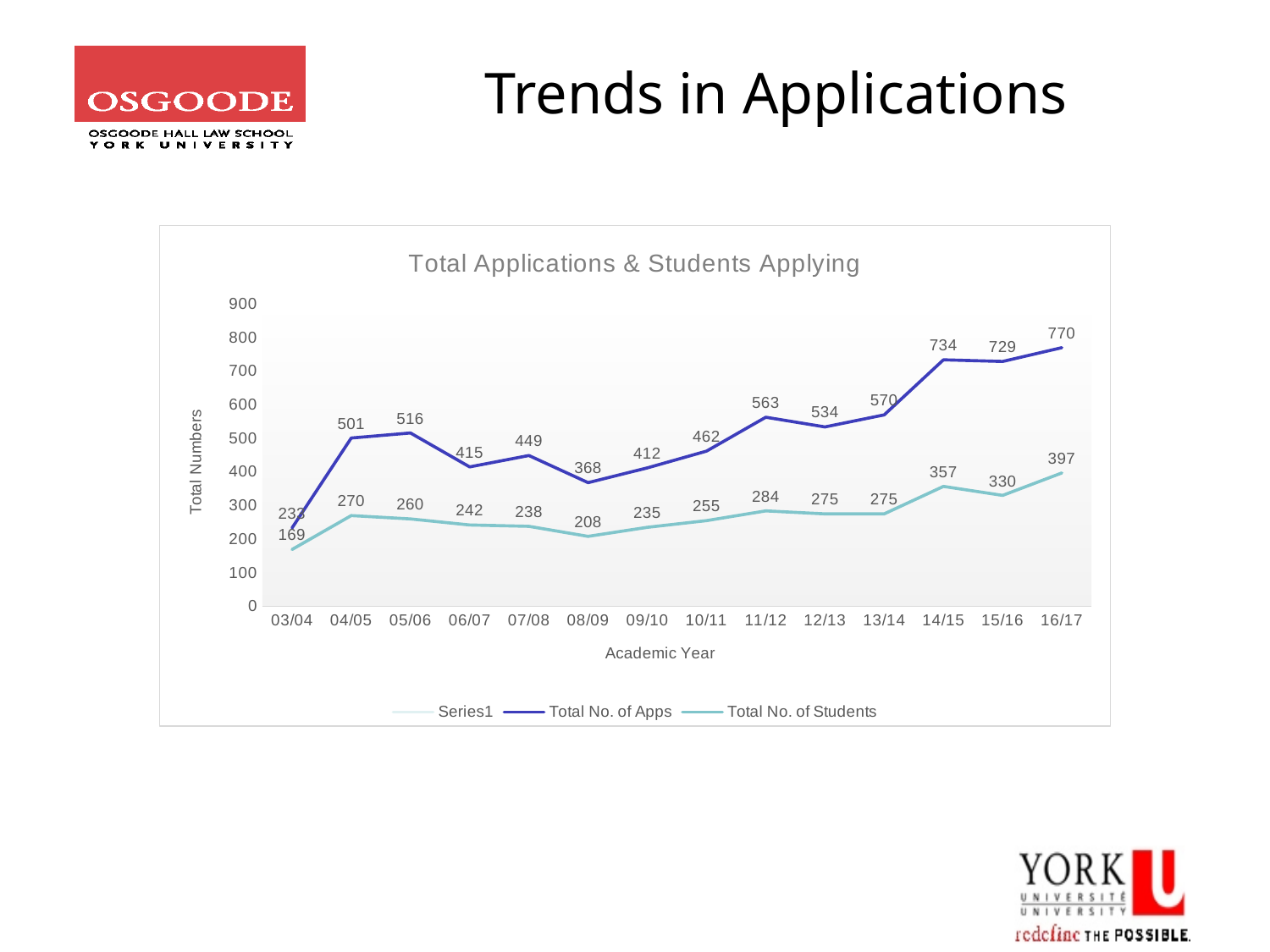
What type of chart is shown on the slide? Line chart What is the Total No. of Apps for 08/09? 368 What is the title of the chart? Total Applications & Students Applying How many academic years are shown on the x axis? 14 Does the Total No. of Apps rise or fall from 13/14 to 14/15? Rise Which is larger: the Total No. of Apps in 05/06 or in 06/07? 05/06 What is the Total No. of Apps for 16/17? 770 In which academic year is the Total No. of Students lowest? 03/04 How many series does the legend list? 3 What is the difference between the Total No. of Apps and the Total No. of Students in 14/15? 377 In which academic year is the Total No. of Apps highest? 16/17 What is the Total No. of Students for 03/04? 169